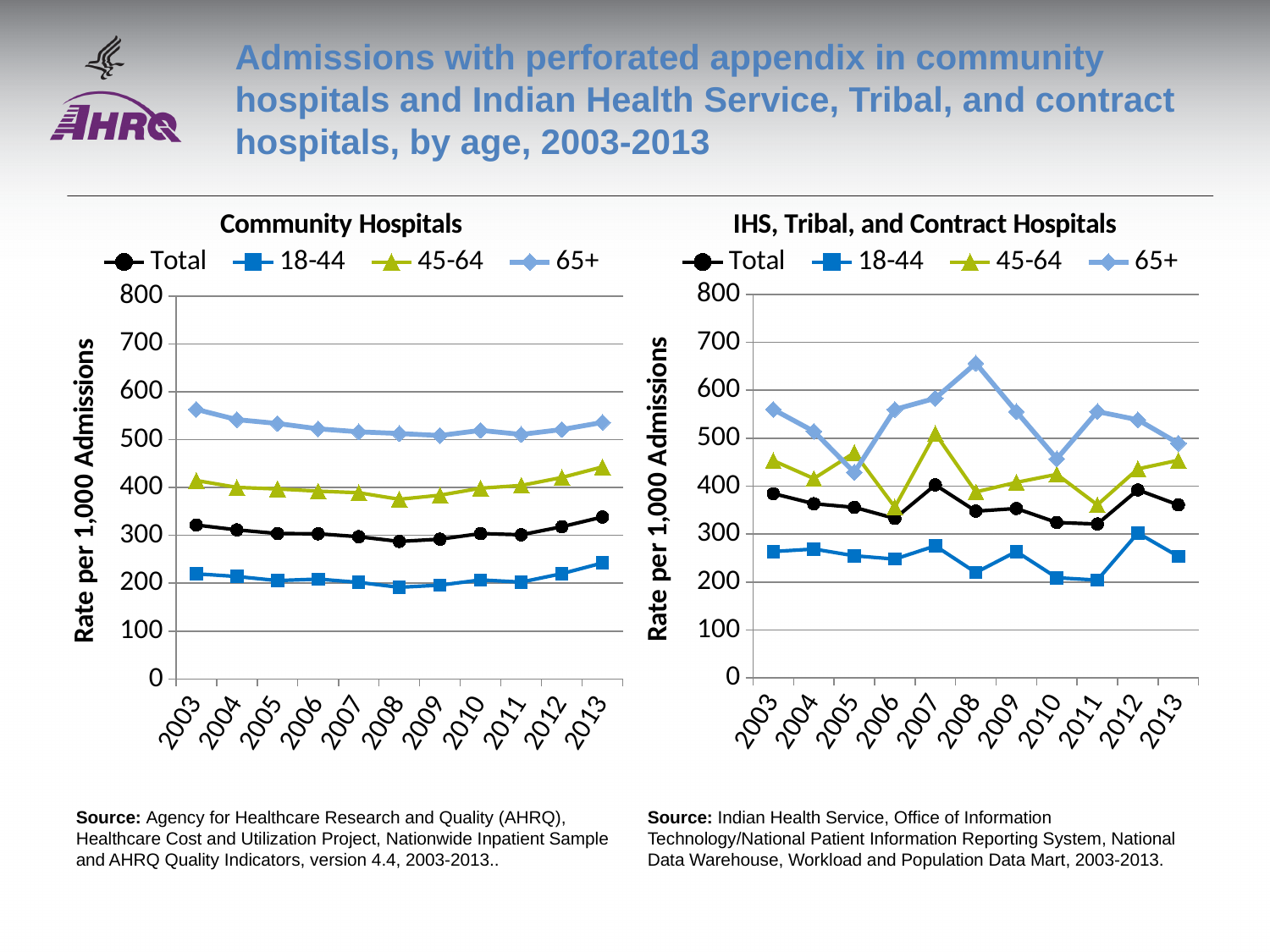
In the Community Hospitals chart, is the value for 45-64 in 2008 greater or less than 400? less In the IHS, Tribal, and Contract Hospitals chart, is the value for 18-44 in 2011 greater or less than 250? less How many years are shown on the x axis of the IHS, Tribal, and Contract Hospitals chart? 11 In the IHS, Tribal, and Contract Hospitals chart, in which year does the 65+ series reach its highest value? 2008 In the Community Hospitals chart, which age group has the lowest rate across all years? 18-44 In the Community Hospitals chart, which age group has the highest rate across all years? 65+ How many series does the legend of the Community Hospitals chart list? 4 In the IHS, Tribal, and Contract Hospitals chart, is the 65+ value larger in 2008 or in 2010? 2008 In the IHS, Tribal, and Contract Hospitals chart, is the value for 65+ in 2008 greater or less than 600? greater What kind of chart is the Community Hospitals chart? Line chart In the Community Hospitals chart, does the 65+ series rise or fall from 2003 to 2008? Fall